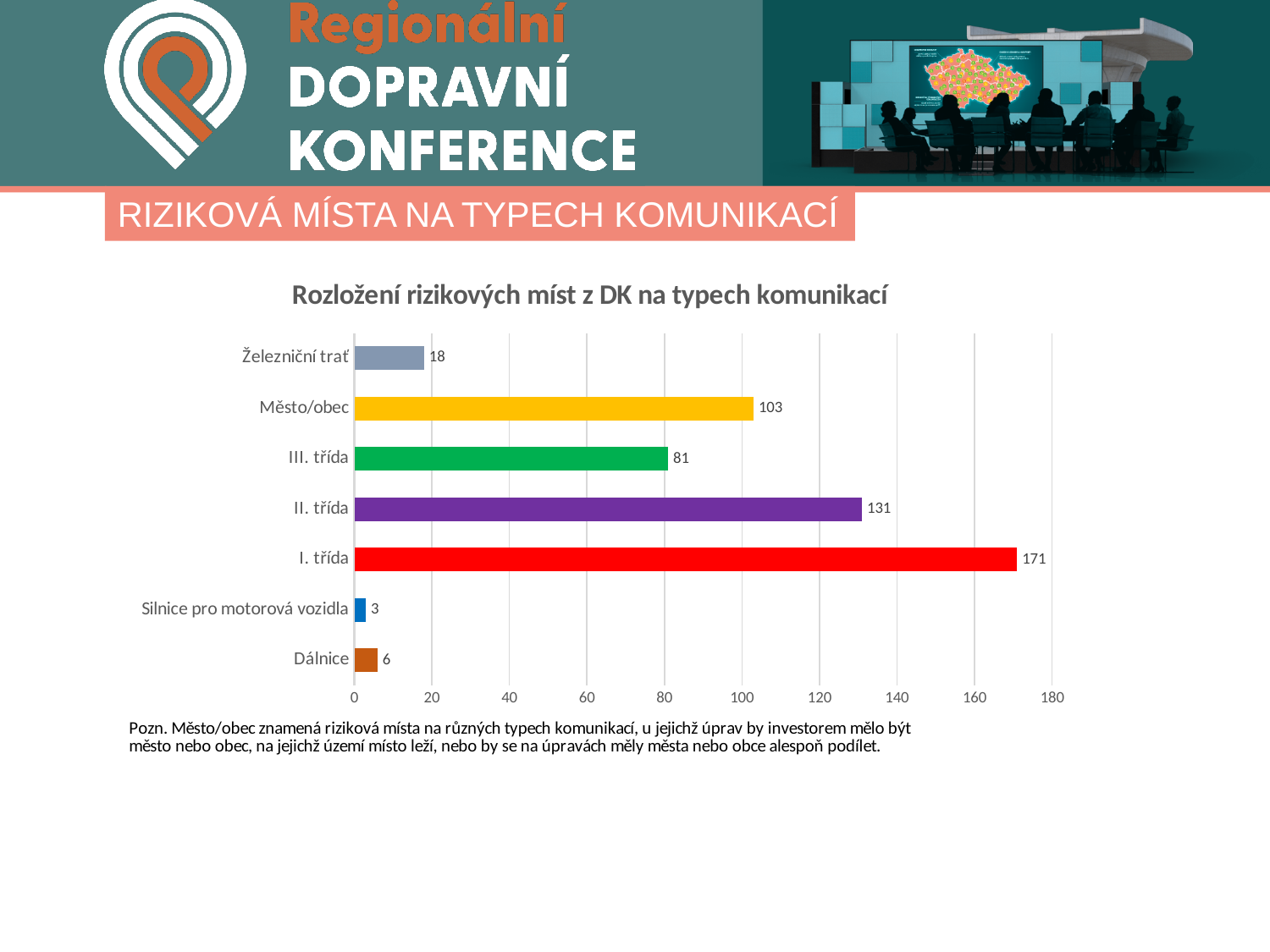
What is the value for I. třída? 171 How many categories are shown in the chart? 7 What is the title of the chart? Rozložení rizikových míst z DK na typech komunikací Which is larger, the value for III. třída or the value for Město/obec? Město/obec What is the value for Město/obec? 103 Is the value for II. třída greater or less than 120? greater What is the value for Silnice pro motorová vozidla? 3 What kind of chart is shown on the slide? bar chart Which category has the highest value? I. třída Which category has the lowest value? Silnice pro motorová vozidla What is the difference between the values for I. třída and II. třída? 40 What is the difference between the values for Dálnice and Silnice pro motorová vozidla? 3